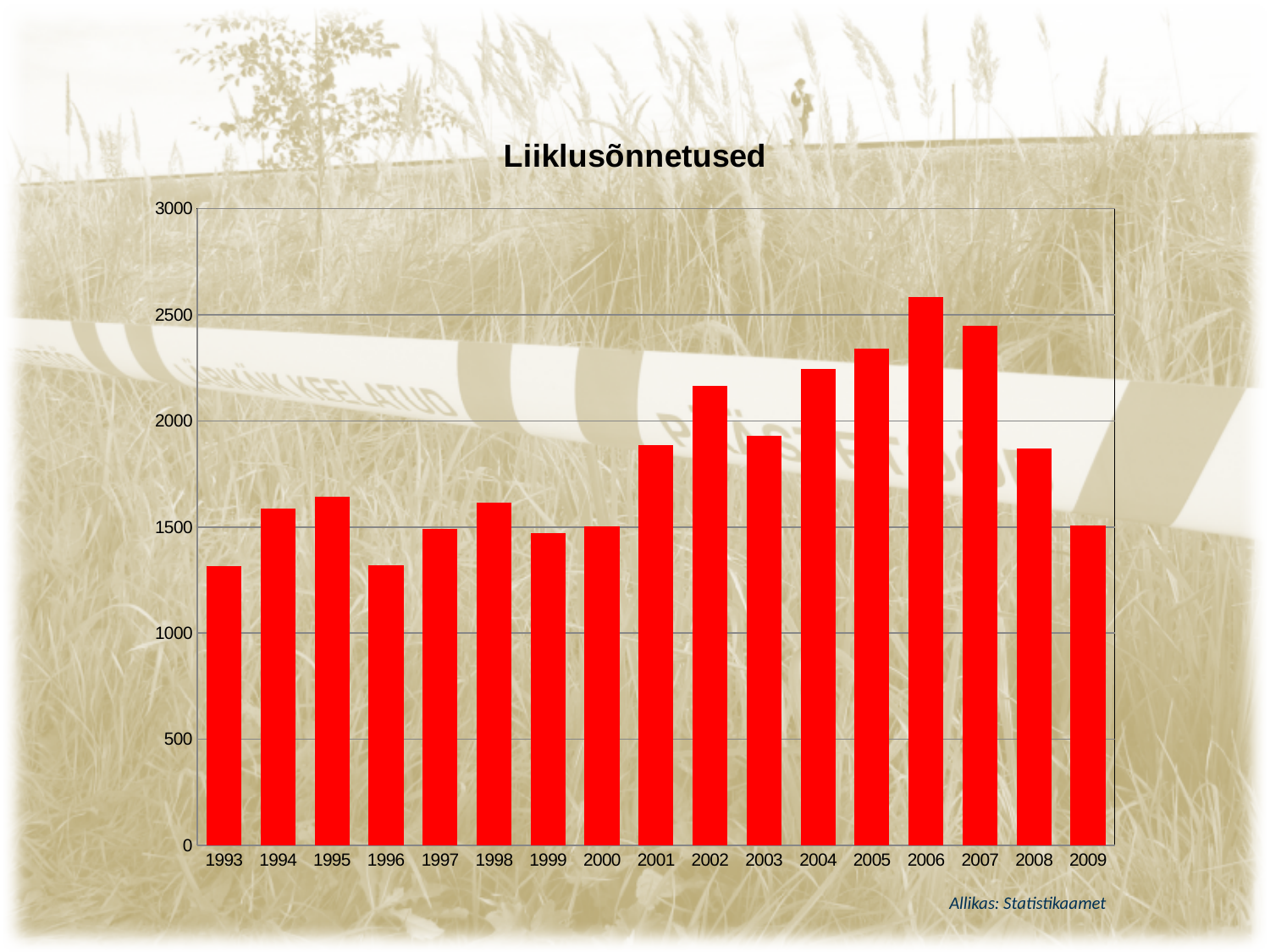
Is the value for 2006 greater or less than 2500? greater Is the value for 2004 greater or less than 2000? greater What is the title of the chart? Liiklusõnnetused Is the value for 2008 greater or less than 2000? less Do the values rise or fall from 2006 to 2009? fall How many years are shown on the x axis of the chart? 17 What kind of chart is shown on the slide? bar chart Which is larger, the value for 2002 or the value for 2003? 2002 What source is cited below the chart? Statistikaamet Which is larger, the value for 2006 or the value for 2008? 2006 Which year has the highest value in the chart? 2006